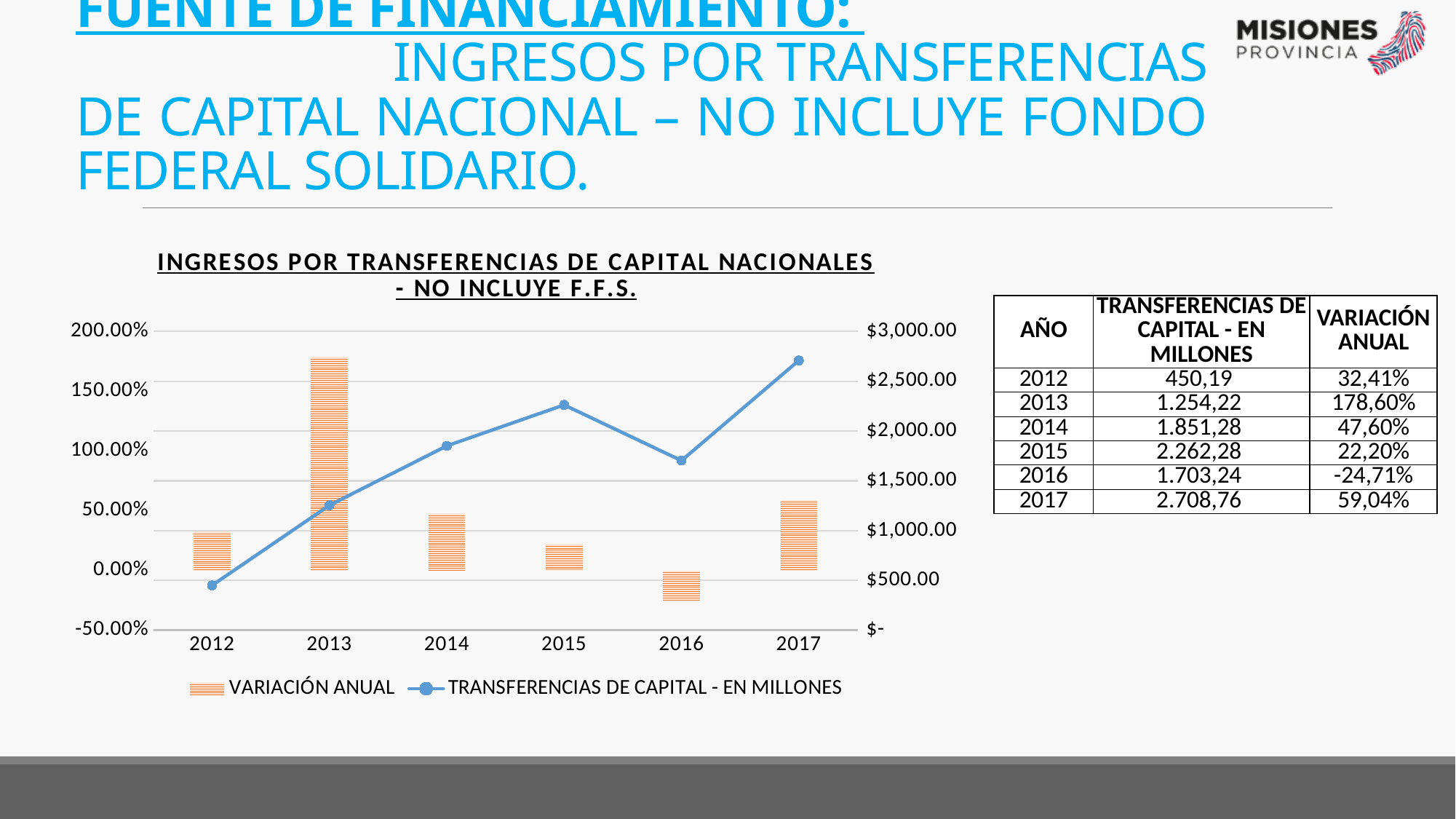
According to the table on the slide, what is the TRANSFERENCIAS DE CAPITAL - EN MILLONES value for 2017? 2.708,76 Does the TRANSFERENCIAS DE CAPITAL - EN MILLONES line rise or fall from 2012 to 2015? rise According to the table on the slide, what is the VARIACIÓN ANUAL for 2016? -24,71% In which year is the VARIACIÓN ANUAL bar the lowest? 2016 Is the TRANSFERENCIAS DE CAPITAL value for 2016 greater or less than $2,000.00? less How many series does the chart legend list? 2 In which year does the TRANSFERENCIAS DE CAPITAL - EN MILLONES line reach its highest point? 2017 In which year is the VARIACIÓN ANUAL bar the highest? 2013 What kind of chart is shown on the slide? A combined bar and line chart Is the VARIACIÓN ANUAL value for 2013 greater or less than 150.00%? greater How many years are plotted along the x axis of the chart? 6 In which year is the TRANSFERENCIAS DE CAPITAL - EN MILLONES line at its lowest point? 2012